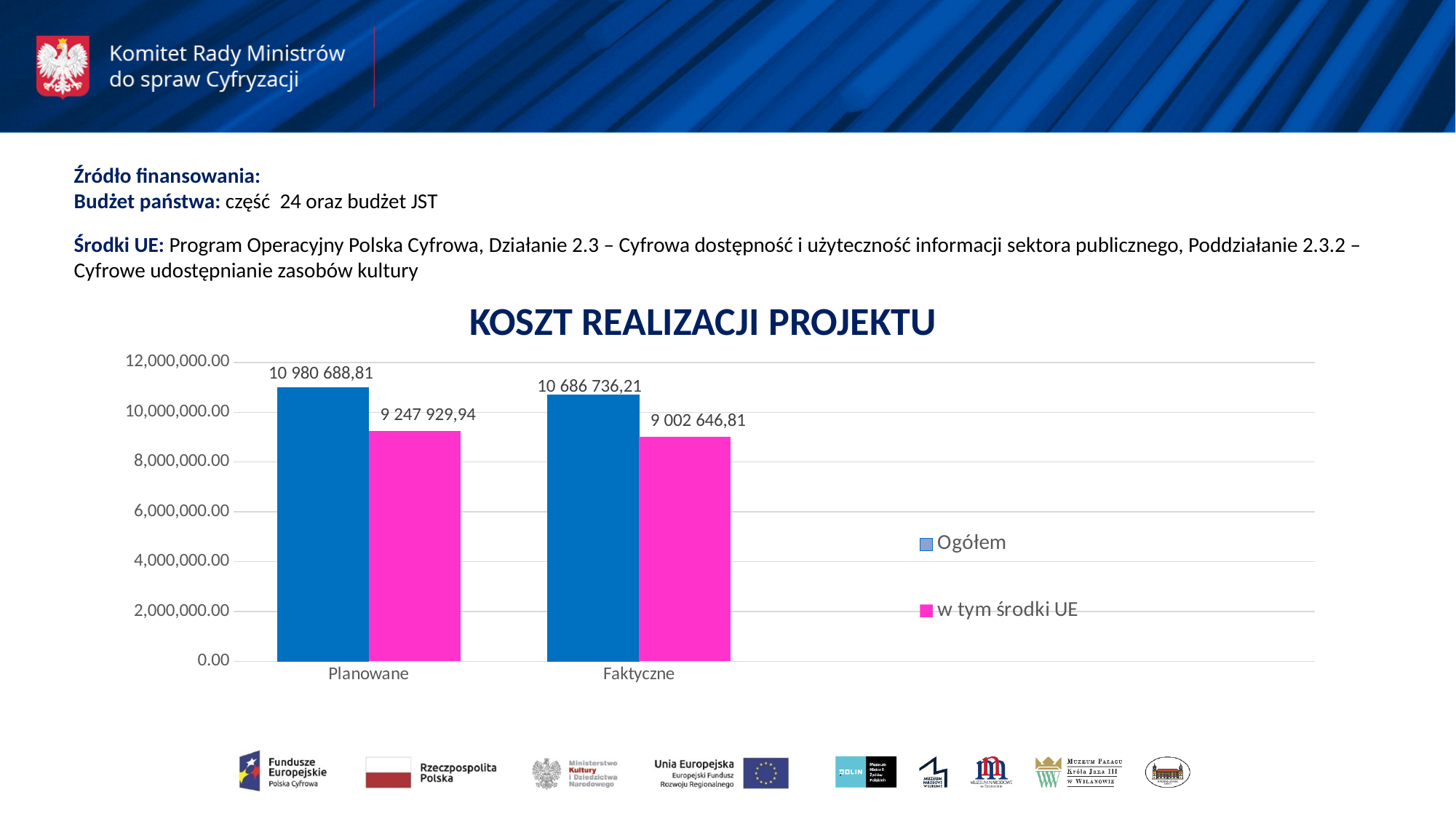
What is the 'w tym środki UE' value for Planowane? 9 247 929,94 What is the difference between the Ogółem and 'w tym środki UE' values for Planowane? 1 732 758,87 How many series does the legend list? 2 How many categories are shown on the x axis? 2 What is the Ogółem value for Planowane? 10 980 688,81 What type of chart is shown? Bar chart What is the 'w tym środki UE' value for Faktyczne? 9 002 646,81 What is the Ogółem value for Faktyczne? 10 686 736,21 Is the Ogółem value for Faktyczne greater or less than 10,000,000.00? greater What is the difference between the Ogółem values for Planowane and Faktyczne? 293 952,60 What is the difference between the 'w tym środki UE' values for Planowane and Faktyczne? 245 283,13 Which category has the higher Ogółem value, Planowane or Faktyczne? Planowane